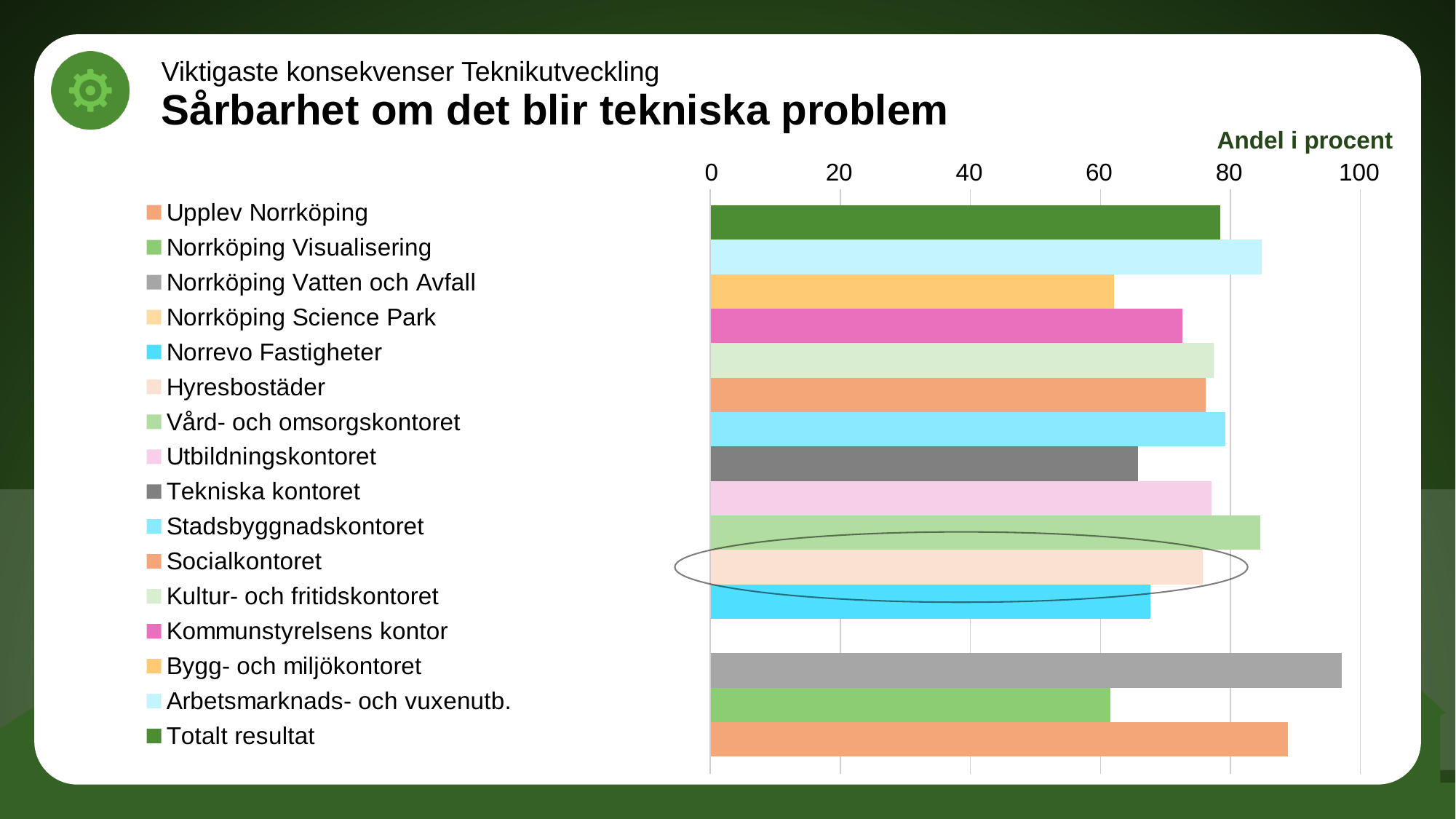
Is the value for Arbetsmarknads- och vuxenutb. greater or less than 80? greater Which is larger, the value for Norrköping Vatten och Avfall or the value for Totalt resultat? Norrköping Vatten och Avfall Is the value for Kommunstyrelsens kontor greater or less than 80? less Which entry has the highest value in the chart? Norrköping Vatten och Avfall Is the value for Norrevo Fastigheter greater or less than 80? less What label is shown above the horizontal axis of the chart? Andel i procent How many entries does the legend list? 16 What is the title of the slide containing the chart? Sårbarhet om det blir tekniska problem Which is larger, the value for Upplev Norrköping or the value for Norrköping Visualisering? Upplev Norrköping What kind of chart is shown on the slide? bar chart